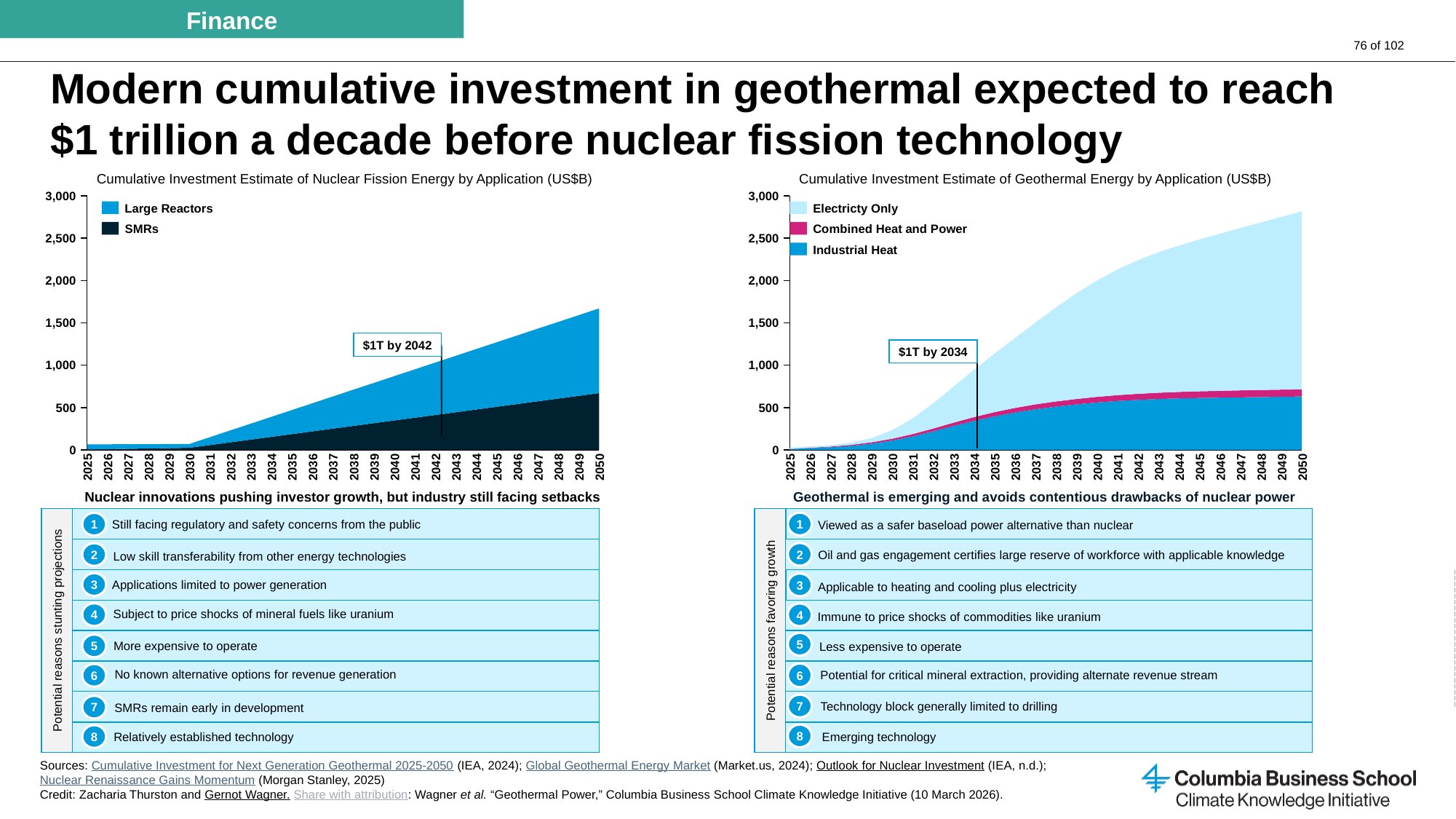
Which chart reaches $1T cumulative investment earlier, the nuclear fission chart or the geothermal chart? The geothermal chart In the nuclear fission chart on the left, is the total cumulative investment in 2035 greater or less than 1,000? less How many series does the legend of the 'Cumulative Investment Estimate of Nuclear Fission Energy by Application' chart list? 2 In the geothermal chart on the right, is the total cumulative investment in 2050 greater or less than 2,500? greater In the nuclear fission chart on the left, in which year does cumulative investment reach $1T according to the annotation? 2042 How many series does the legend of the 'Cumulative Investment Estimate of Geothermal Energy by Application' chart list? 3 In the nuclear fission chart on the left, is the total cumulative investment in 2050 greater or less than 1,500? greater What kind of chart is the 'Cumulative Investment Estimate of Nuclear Fission Energy by Application' chart? Stacked area chart In the geothermal chart on the right, in which year does cumulative investment reach $1T according to the annotation? 2034 What are the two legend entries of the nuclear fission chart on the left? Large Reactors and SMRs How many years are shown on the x axis of the geothermal chart on the right? 26 In the nuclear fission chart on the left, does total cumulative investment rise or fall from 2025 to 2050? Rise